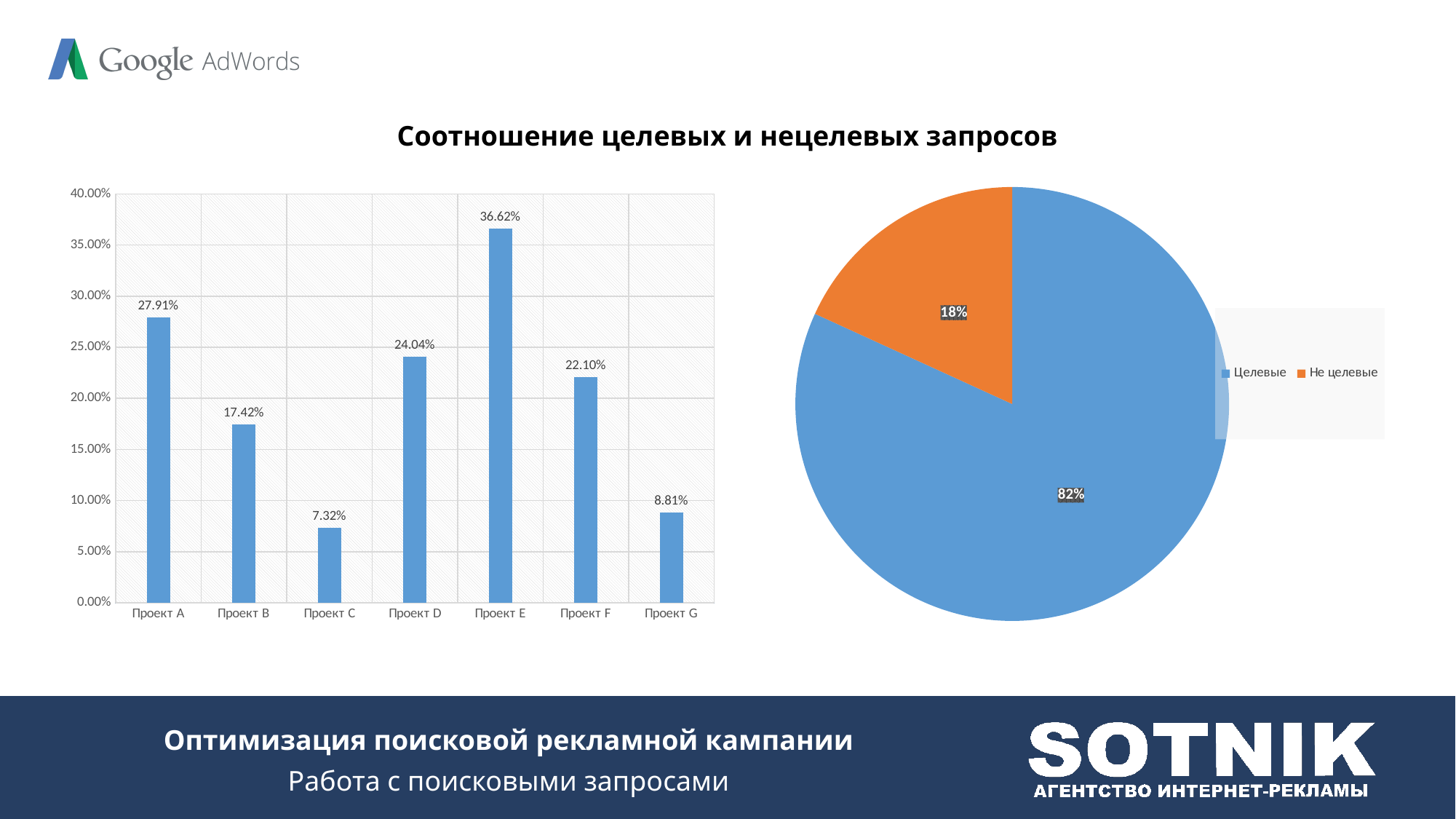
In the bar chart on the left, what is the value for Проект E? 36.62% In the bar chart on the left, what is the value for Проект C? 7.32% What kind of chart is the chart on the left? bar chart In the bar chart on the left, how many projects are shown on the x axis? 7 In the bar chart on the left, what is the difference between the values for Проект A and Проект B? 10.49% In the bar chart on the left, which project has the highest value? Проект E In the pie chart on the right, what share does the Целевые slice have? 82% How many entries does the legend of the pie chart on the right list? 2 In the bar chart on the left, which is larger: the value for Проект D or the value for Проект F? Проект D In the pie chart on the right, what share does the Не целевые slice have? 18% What is the title shown above the charts on the slide? Соотношение целевых и нецелевых запросов In the bar chart on the left, which project has the lowest value? Проект C